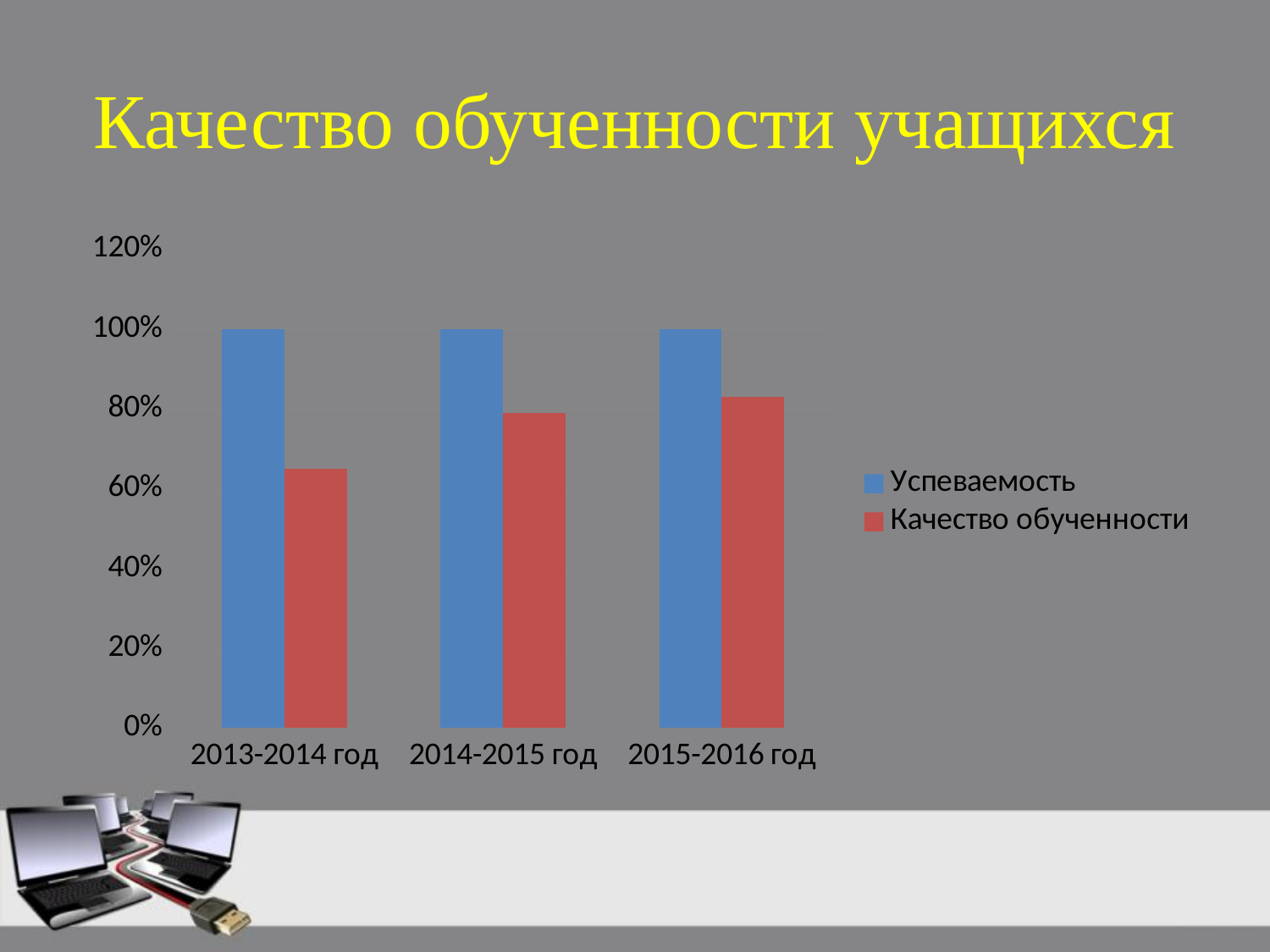
Which is larger for 2013-2014 год: Успеваемость or Качество обученности? Успеваемость How many series does the legend list? 2 Which year has the highest value for Качество обученности? 2015-2016 год Is the value of Качество обученности for 2015-2016 год greater or less than 80%? greater Which year has the lowest value for Качество обученности? 2013-2014 год Does the value of Качество обученности rise or fall from 2013-2014 год to 2015-2016 год? rise What kind of chart is shown on the slide? bar chart Is the value of Качество обученности for 2014-2015 год greater or less than 60%? greater Is the value of Качество обученности for 2013-2014 год greater or less than 80%? less How many categories are shown on the x axis? 3 What is the value of Успеваемость for 2013-2014 год? 100% What is the value of Успеваемость for 2015-2016 год? 100%